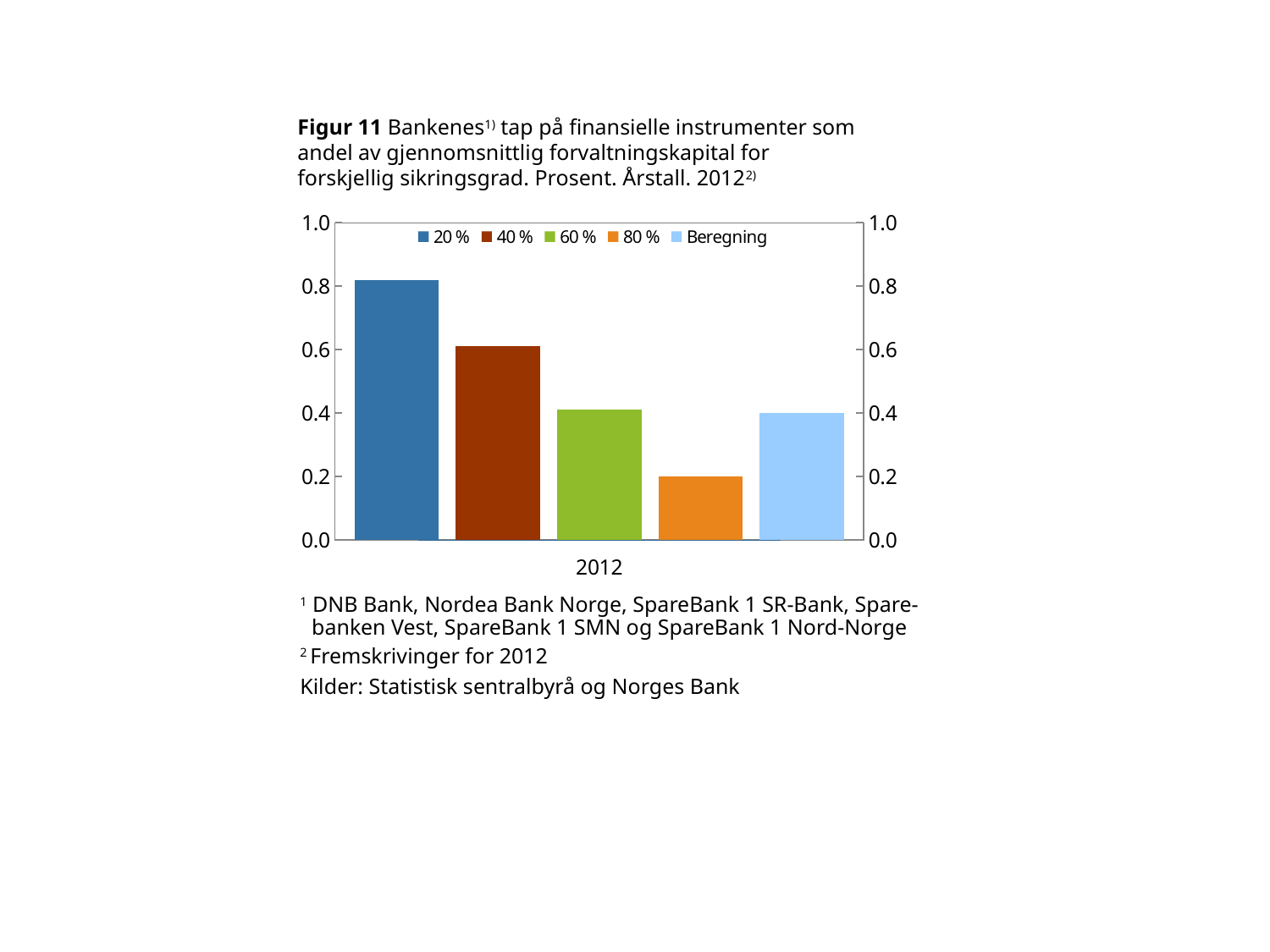
Which series has the lowest bar? 80 % Which is larger, the bar for 20 % or the bar for 40 %? 20 % Which is larger, the bar for 60 % or the bar for 80 %? 60 % What is the value for the 80 % series? 0.2 What kind of chart is shown on the slide? bar chart What year is shown on the x axis? 2012 Which series has the highest bar? 20 % Is the value for 80 % greater or less than 0.4? less How many series does the legend list? 5 Is the value for 20 % greater or less than 0.6? greater How many categories are shown on the x axis? 1 Is the value for 40 % greater or less than 0.8? less